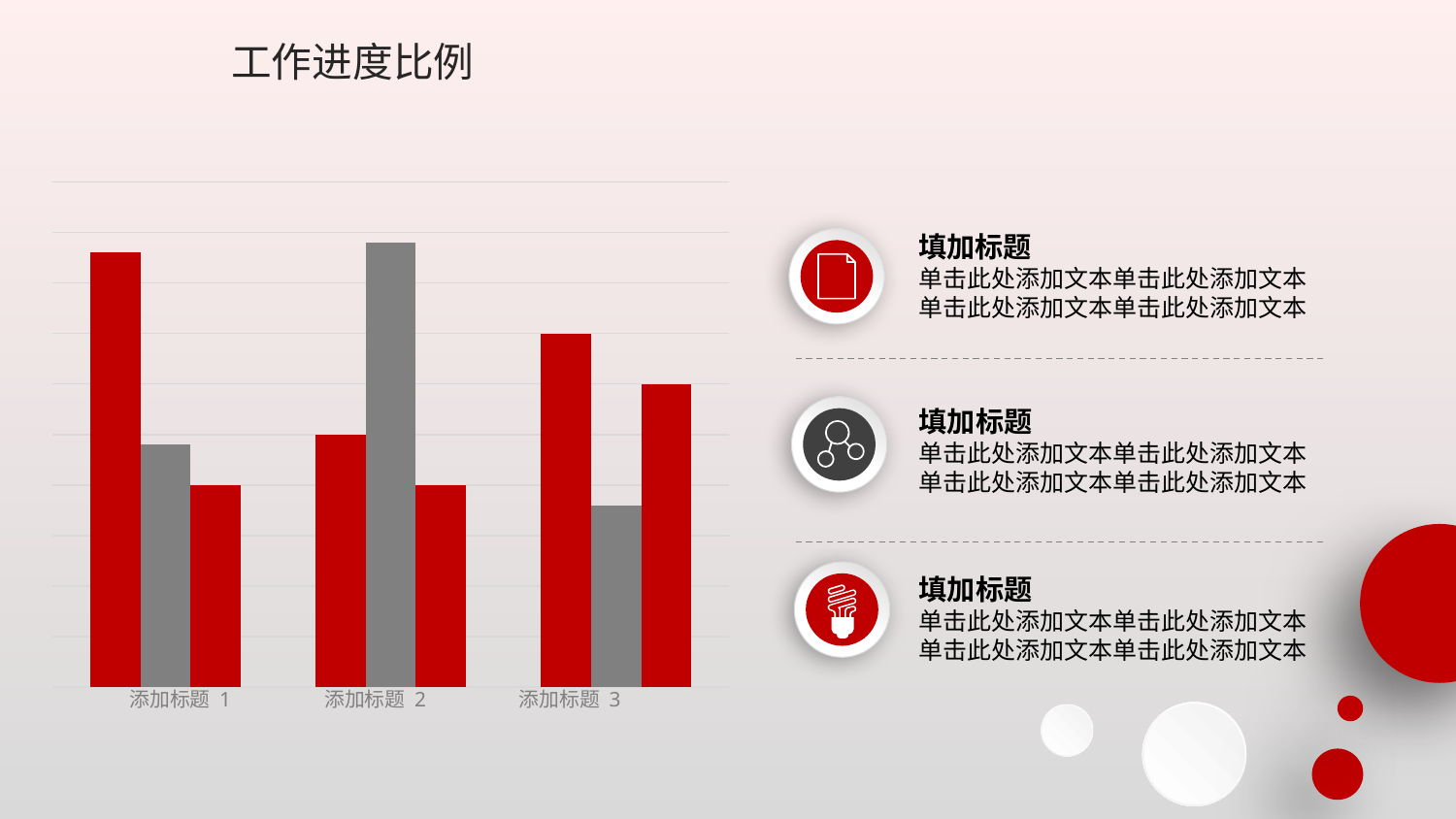
In the category 添加标题 2, which of the three bars is the tallest? the middle (gray) bar Does the third (red) bar rise or fall from 添加标题 2 to 添加标题 3? rise Does the middle (gray) bar rise or fall from 添加标题 2 to 添加标题 3? fall Does the first (red) bar rise or fall from 添加标题 1 to 添加标题 2? fall Which two colours are used for the bars in the chart? red and gray What is the title of the slide containing the chart? 工作进度比例 Which category contains the tallest bar in the chart? 添加标题 2 What kind of chart is shown on the slide? bar chart How many categories are shown on the x axis of the chart? 3 In the category 添加标题 1, is the first (red) bar or the middle (gray) bar taller? the first (red) bar In the category 添加标题 3, which of the three bars is the shortest? the middle (gray) bar How many bars are plotted for each category in the chart? 3